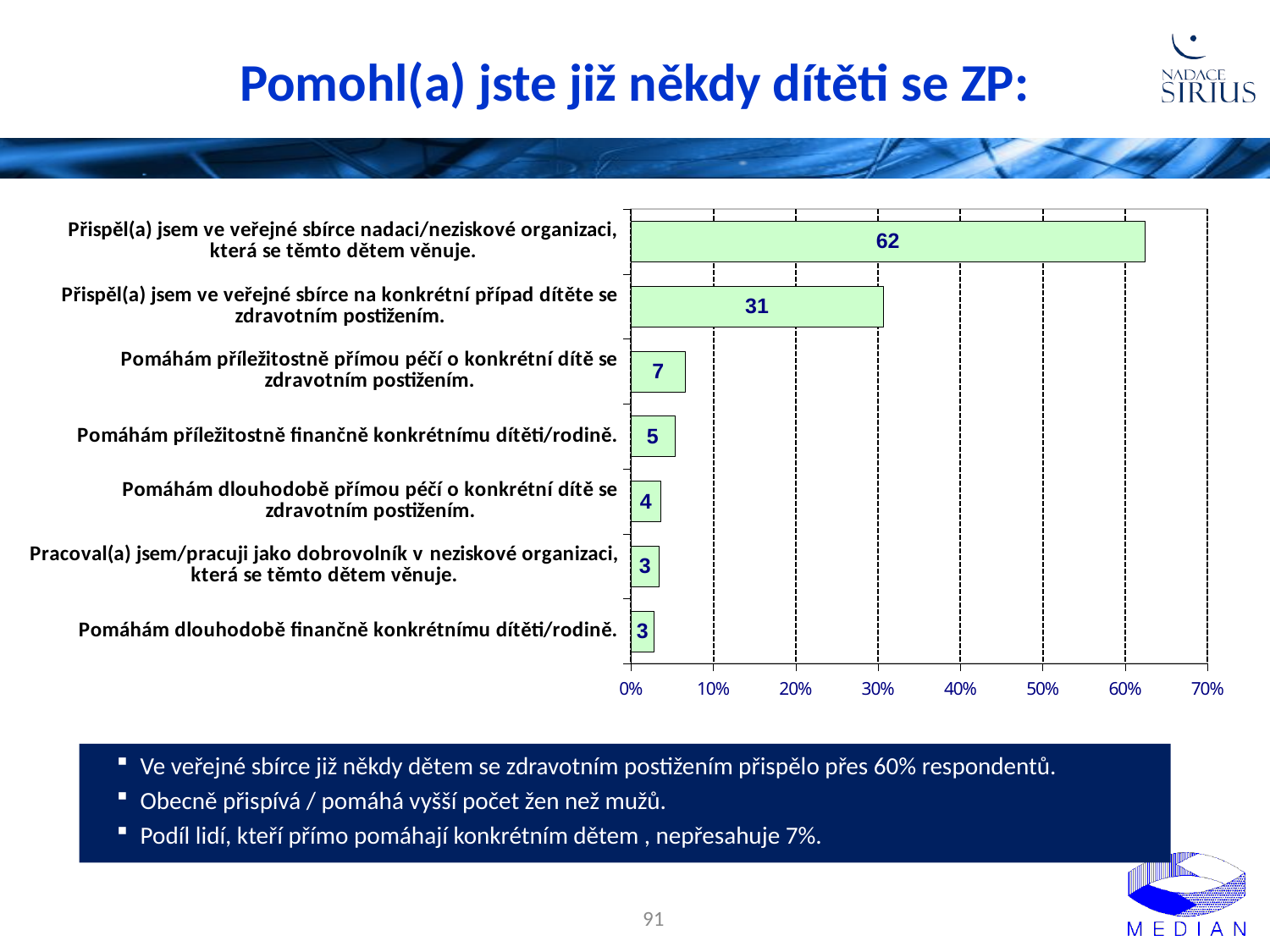
Which is larger: the value for "Pomáhám příležitostně přímou péčí o konkrétní dítě se zdravotním postižením." or for "Pomáhám dlouhodobě přímou péčí o konkrétní dítě se zdravotním postižením."? Pomáhám příležitostně přímou péčí o konkrétní dítě se zdravotním postižením. What value is shown for "Pracoval(a) jsem/pracuji jako dobrovolník v neziskové organizaci, která se těmto dětem věnuje."? 3 Which category has the highest value? Přispěl(a) jsem ve veřejné sbírce nadaci/neziskové organizaci, která se těmto dětem věnuje. What is the title of the slide? Pomohl(a) jste již někdy dítěti se ZP: What value is shown for "Pomáhám příležitostně přímou péčí o konkrétní dítě se zdravotním postižením."? 7 How many categories are shown in the chart? 7 What value is shown for "Přispěl(a) jsem ve veřejné sbírce nadaci/neziskové organizaci, která se těmto dětem věnuje."? 62 What value is shown for "Pomáhám příležitostně finančně konkrétnímu dítěti/rodině."? 5 Is the value for "Přispěl(a) jsem ve veřejné sbírce nadaci/neziskové organizaci, která se těmto dětem věnuje." greater or less than 60%? greater What kind of chart is shown on the slide? bar chart What value is shown for "Přispěl(a) jsem ve veřejné sbírce na konkrétní případ dítěte se zdravotním postižením."? 31 What is the difference between the values for "Přispěl(a) jsem ve veřejné sbírce nadaci/neziskové organizaci, která se těmto dětem věnuje." and "Přispěl(a) jsem ve veřejné sbírce na konkrétní případ dítěte se zdravotním postižením."? 31